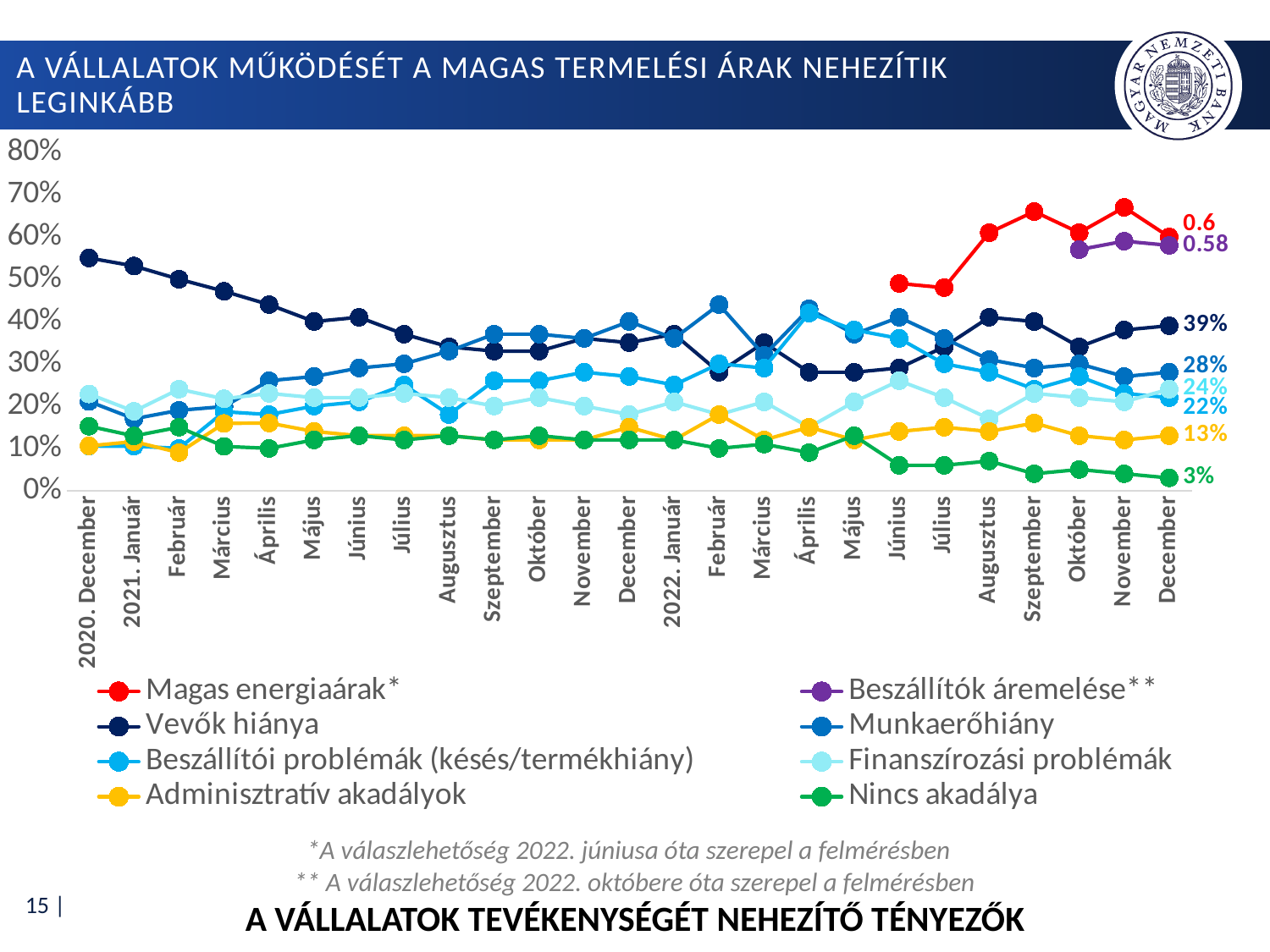
What is the value for Nincs akadálya in December 2022? 3% Is the value for Vevők hiánya in 2020 December greater or less than 50%? greater What is the value for Magas energiaárak in December 2022? 0.6 What is the difference between Vevők hiánya and Munkaerőhiány in December 2022? 11 percentage points Which series has the highest value in December 2022? Magas energiaárak What is the value for Vevők hiánya in December 2022? 39% Does the Vevők hiánya line rise or fall from 2020 December to 2021 August? fall What is the value for Munkaerőhiány in December 2022? 28% Which is larger in December 2022, Adminisztratív akadályok or Nincs akadálya? Adminisztratív akadályok How many series does the legend list? 8 What kind of chart is shown on the slide? line chart Which series has the lowest value in December 2022? Nincs akadálya